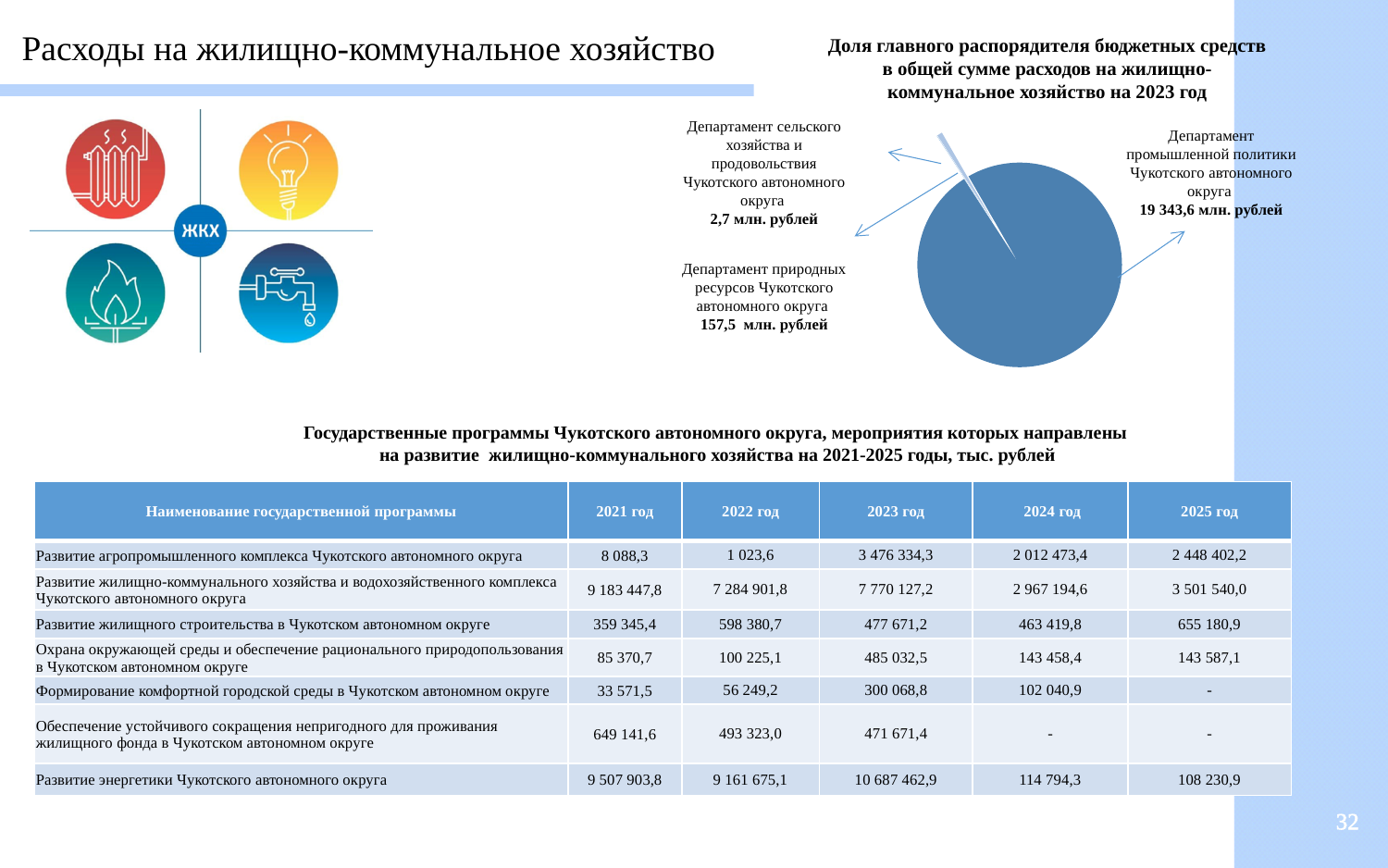
What is the title of the pie chart? Доля главного распорядителя бюджетных средств в общей сумме расходов на жилищно-коммунальное хозяйство на 2023 год How many slices does the pie chart have? 3 Which department has the largest share of the pie chart? Департамент промышленной политики Чукотского автономного округа What kind of chart is shown on the slide? Pie chart Which department has the smallest share of the pie chart? Департамент сельского хозяйства и продовольствия Чукотского автономного округа What is the difference between the values for Департамент промышленной политики and Департамент природных ресурсов? 19 186,1 млн. рублей What is the difference between the values for Департамент природных ресурсов and Департамент сельского хозяйства и продовольствия? 154,8 млн. рублей What is the total of the three values shown on the pie chart? 19 503,8 млн. рублей Which is larger: the value for Департамент природных ресурсов or for Департамент сельского хозяйства и продовольствия? Департамент природных ресурсов What value is shown for Департамент природных ресурсов Чукотского автономного округа? 157,5 млн. рублей What value is shown for Департамент сельского хозяйства и продовольствия Чукотского автономного округа? 2,7 млн. рублей What value is shown for Департамент промышленной политики Чукотского автономного округа? 19 343,6 млн. рублей